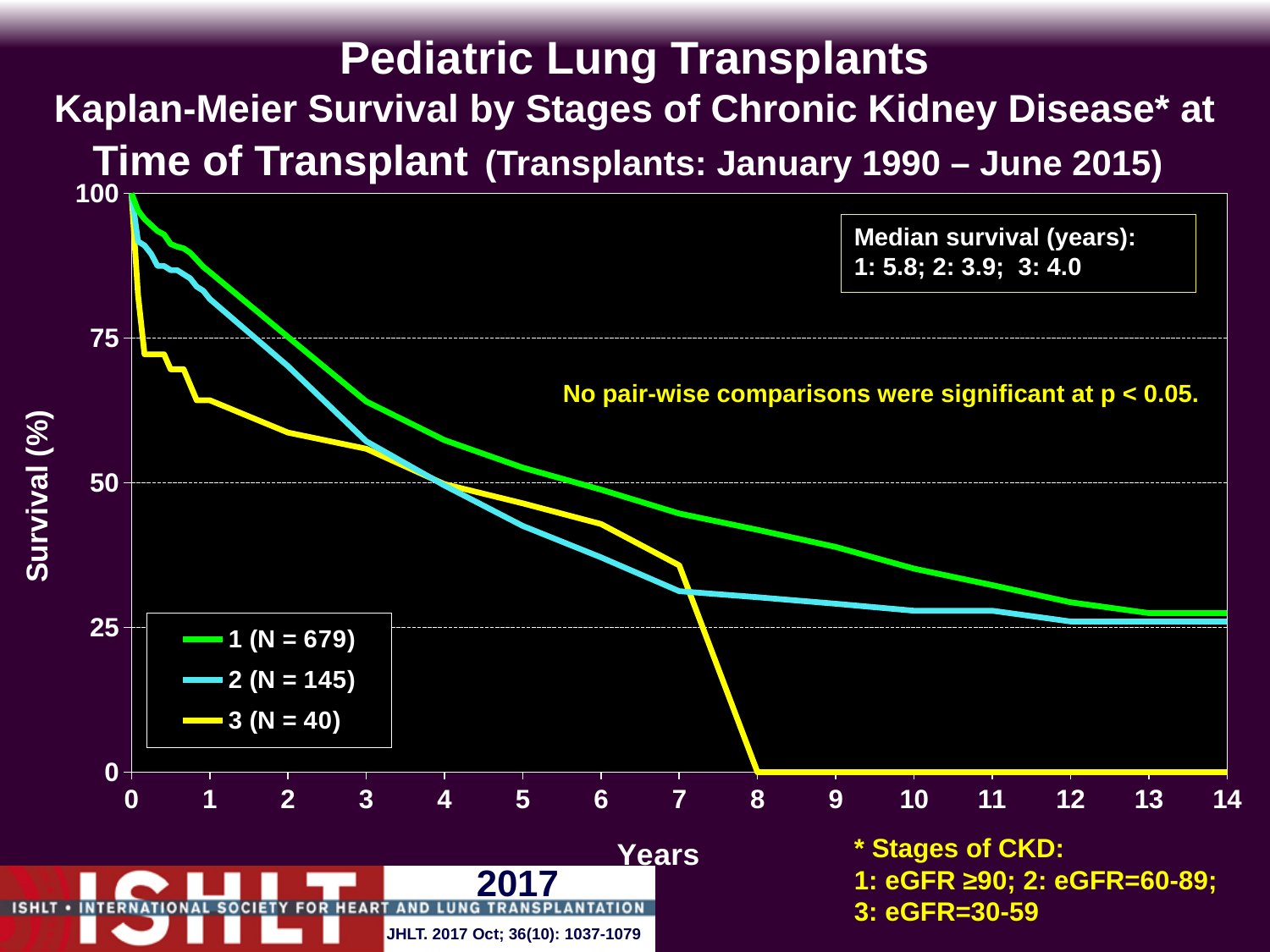
Is the survival for stage 1 at 3 years greater or less than 50? greater What is the median survival in years for stage 2? 3.9 Which group has more patients, stage 2 (N = 145) or stage 3 (N = 40)? 2 (N = 145) What kind of chart is shown on the slide? line chart How many series does the legend list? 3 Do the survival curves rise or fall as years increase? fall Which CKD stage has the longest median survival? 1 Which CKD stage has the shortest median survival? 2 What is the difference in median survival (years) between stage 1 and stage 2? 1.9 Is the survival for stage 3 at 10 years greater or less than 25? less What is the median survival in years for stage 1? 5.8 What is the label of the y axis? Survival (%)